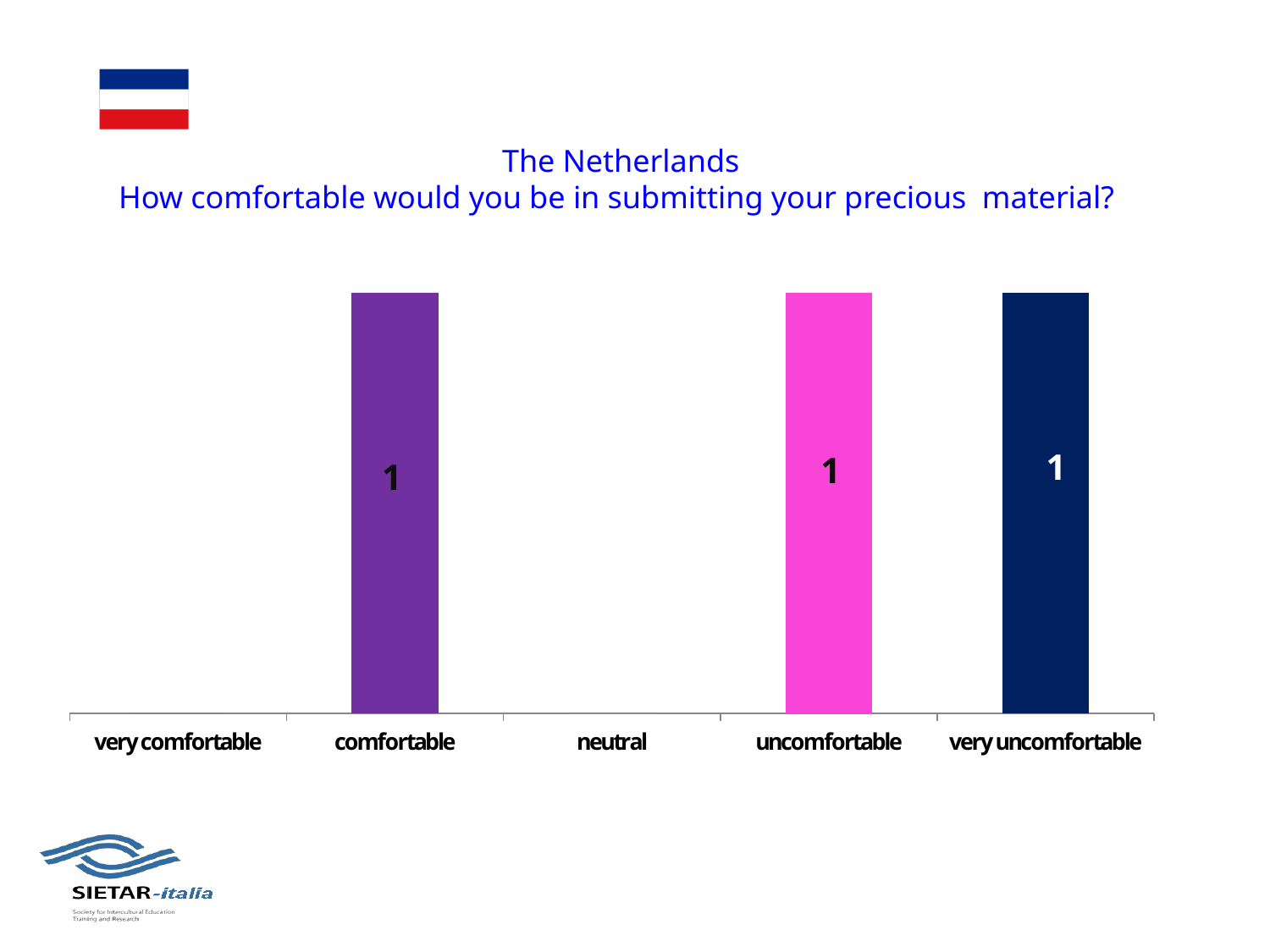
Is the value for "comfortable" larger than, smaller than, or equal to the value for "very uncomfortable"? equal What is the value for "very uncomfortable"? 1 How many categories are shown on the x axis? 5 What is the difference between the values for "comfortable" and "uncomfortable"? 0 Which categories show no bar at all? very comfortable and neutral How many categories have a visible bar? 3 What kind of chart is shown on the slide? bar chart What is the total of the values for "comfortable", "uncomfortable" and "very uncomfortable"? 3 What is the value for "comfortable"? 1 Which country does the chart title refer to? The Netherlands What is the value for "uncomfortable"? 1